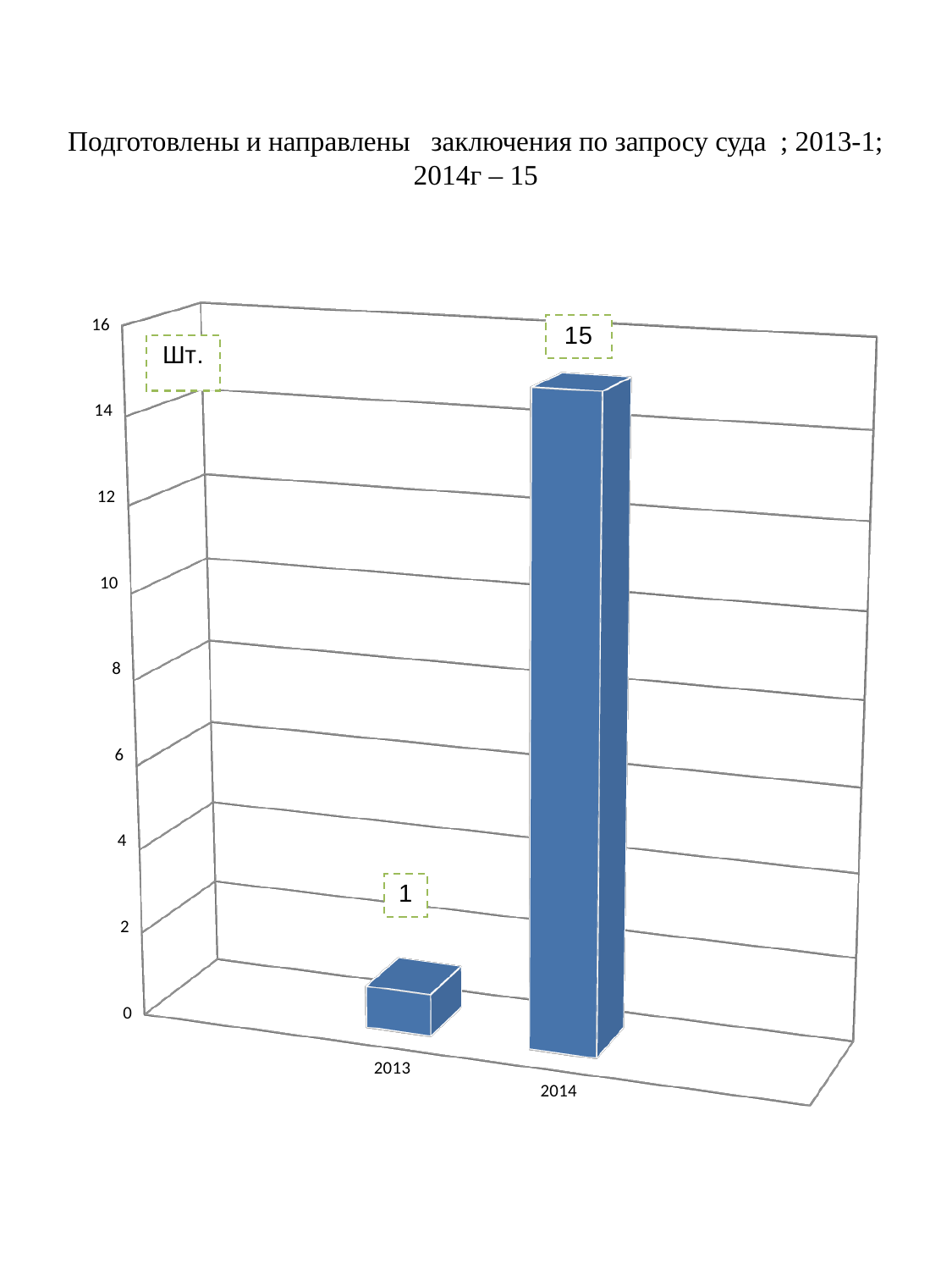
How many categories are shown on the x axis? 2 Which is larger, the value for 2013 or the value for 2014? 2014 Which year has the highest value? 2014 What is the value for 2013? 1 Do the values rise or fall from 2013 to 2014? rise Is the value for 2013 greater or less than 4? less What unit label is shown in the box at the top left of the chart? Шт. What is the value for 2014? 15 What kind of chart is shown on the slide? bar chart What is the difference between the values for 2014 and 2013? 14 Which year has the lowest value? 2013 Is the value for 2014 greater or less than 10? greater